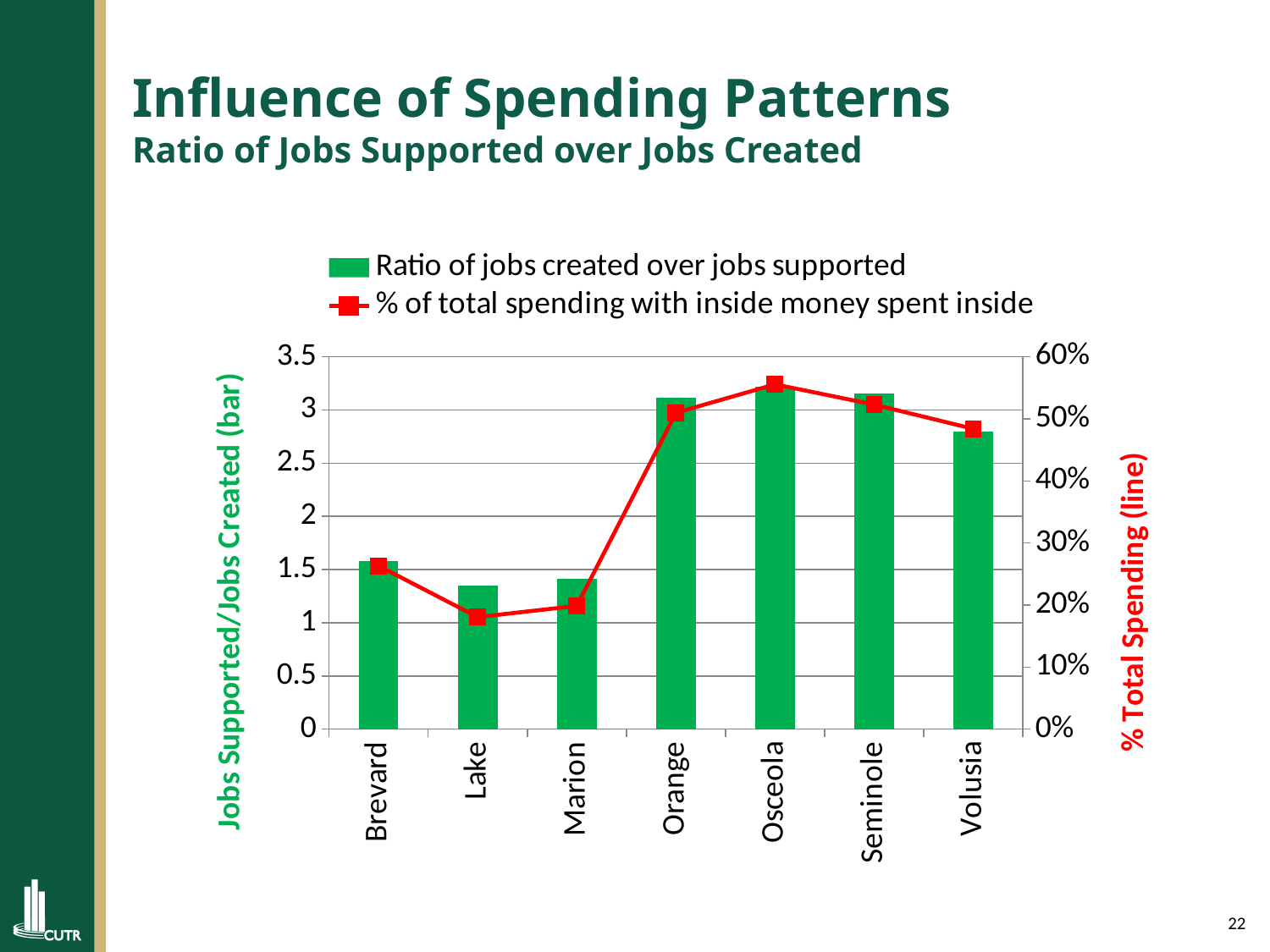
How many series does the chart legend list? 2 Which has the larger bar value, Orange or Brevard? Orange Is the bar value for Lake greater or less than 1.5? less What is the label of the left vertical axis? Jobs Supported/Jobs Created (bar) What kind of chart is used for the 'Ratio of jobs created over jobs supported' series? Bar chart Is the bar value for Volusia greater or less than 2.5? greater Is the bar value for Orange greater or less than 3? greater How many counties are shown on the x axis of the chart? 7 What colour is the line series for % of total spending? Red Which has the larger line value for % of total spending, Seminole or Lake? Seminole